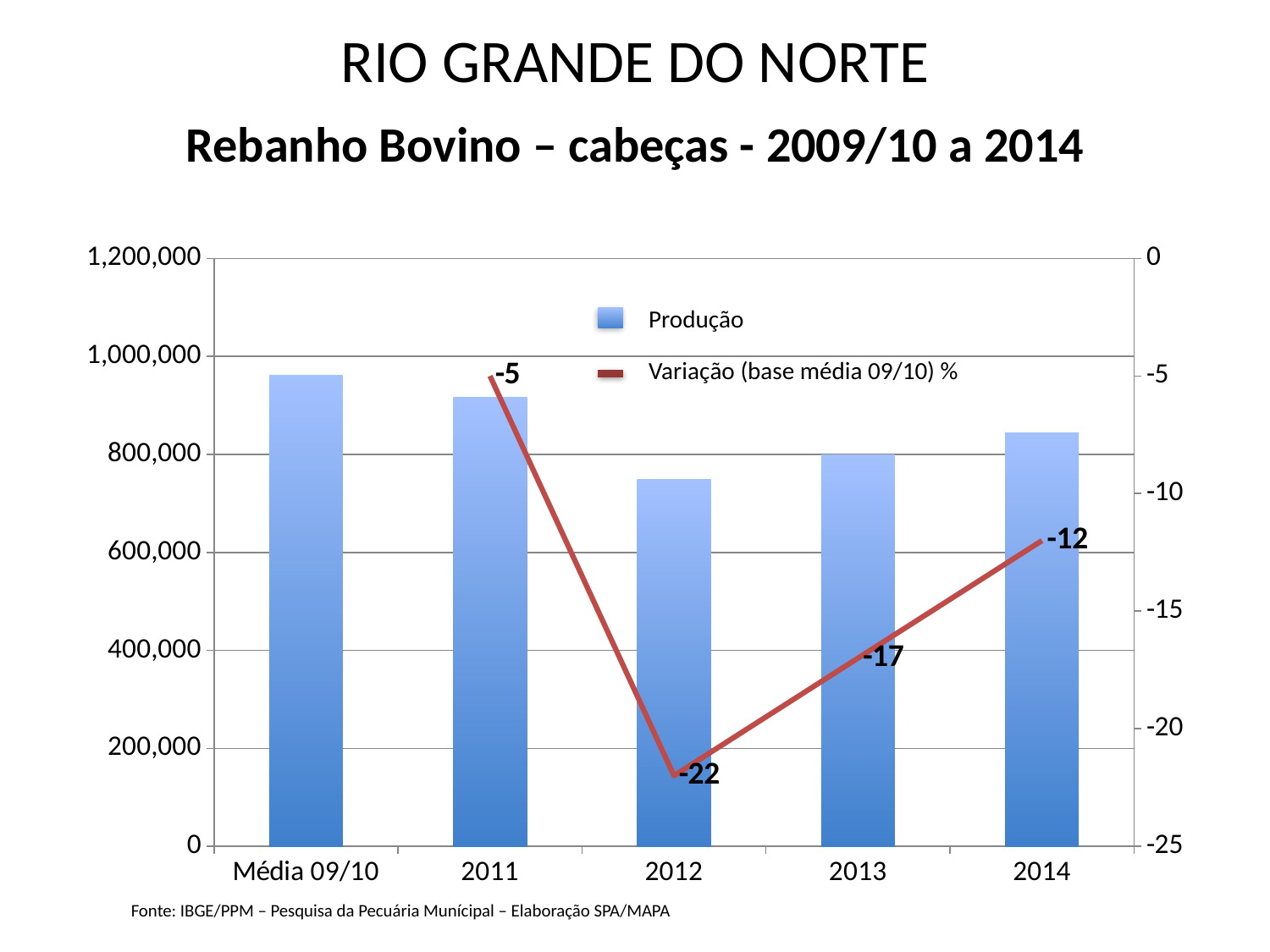
Is the Produção value for Média 09/10 greater or less than 1,000,000? less How many categories are shown on the x axis? 5 What is the value of Variação (base média 09/10) % for 2011? -5 Which is larger, the Variação value for 2013 or for 2014? 2014 What is the difference between the Variação values for 2011 and 2012? 17 How many series does the legend list? 2 Which year has the lowest Variação (base média 09/10) % value? 2012 Which year has the lowest Produção bar? 2012 What is the value of Variação (base média 09/10) % for 2014? -12 What is the value of Variação (base média 09/10) % for 2012? -22 Which category has the highest Produção bar? Média 09/10 Is the Produção value for 2012 greater or less than 800,000? less